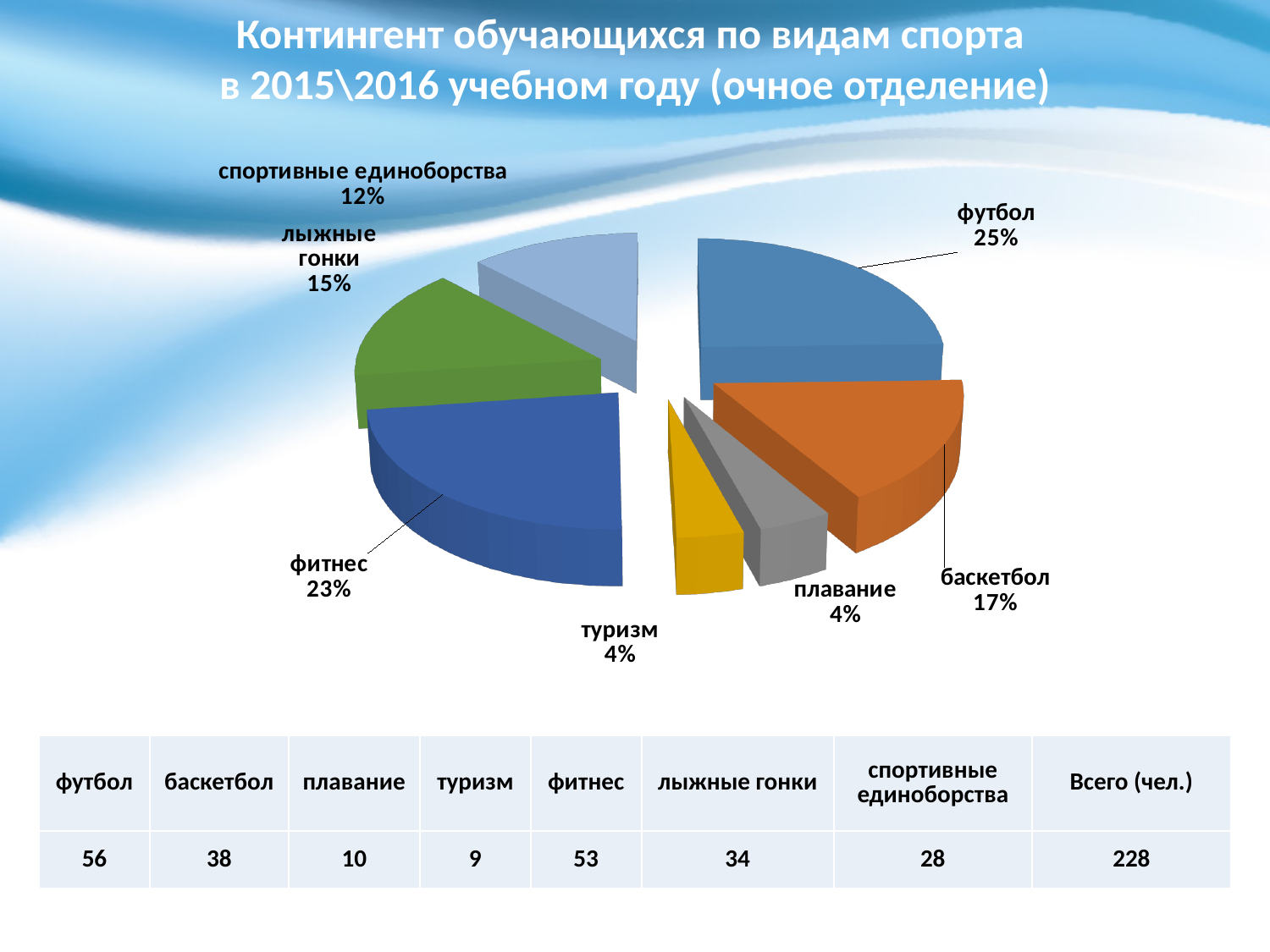
What share of the pie does спортивные единоборства have? 12% Which category has the largest share of the pie? футбол What share of the pie does баскетбол have? 17% What kind of chart is shown on the slide? pie chart What is the combined share of плавание and туризм? 8% What share of the pie does фитнес have? 23% What colour is the slice for лыжные гонки? green How many categories (slices) does the pie chart have? 7 What is the difference in percentage points between the shares of футбол and баскетбол? 8% Which has a larger share of the pie, фитнес or лыжные гонки? фитнес